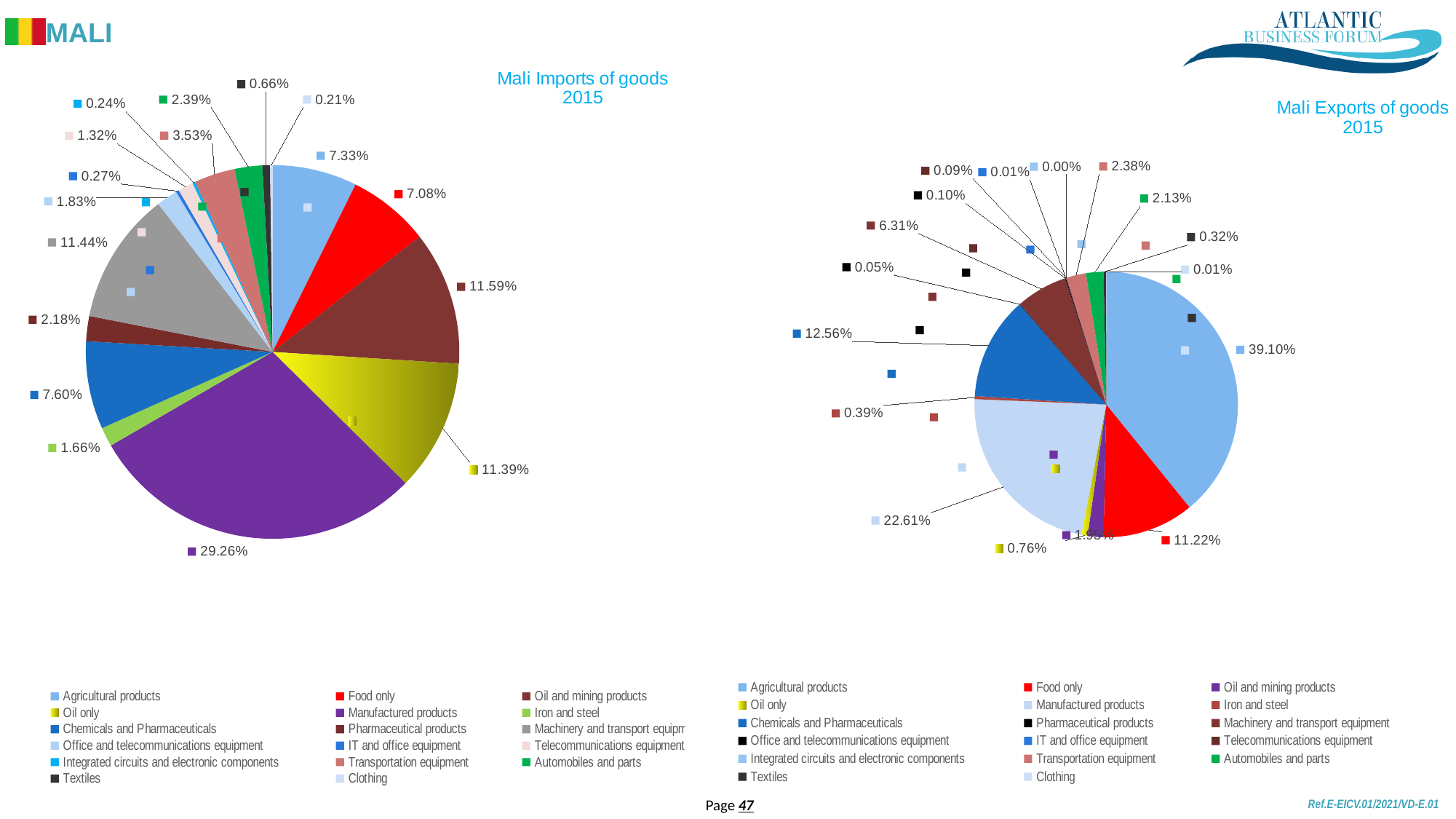
In the Mali Exports of goods 2015 chart, what is the difference between the shares of Chemicals and Pharmaceuticals and Food only? 1.34% In the Mali Imports of goods 2015 chart, which is larger: Agricultural products or Food only? Agricultural products In the Mali Imports of goods 2015 chart, what is the share for Machinery and transport equipment? 11.44% In the Mali Exports of goods 2015 chart, what share do Agricultural products have? 39.10% In the Mali Imports of goods 2015 chart, which category has the largest share? Manufactured products What type of chart is used for Mali Imports of goods 2015? pie chart In the Mali Imports of goods 2015 chart, what is the difference between the shares of Oil and mining products and Oil only? 0.20% In the Mali Exports of goods 2015 chart, what is the share for Manufactured products? 22.61% In the Mali Exports of goods 2015 chart, which is larger: Transportation equipment or Automobiles and parts? Transportation equipment How many categories does the legend of the Mali Exports of goods 2015 chart list? 17 In the Mali Imports of goods 2015 chart, what share do Manufactured products have? 29.26% In the Mali Exports of goods 2015 chart, which category has the largest share? Agricultural products